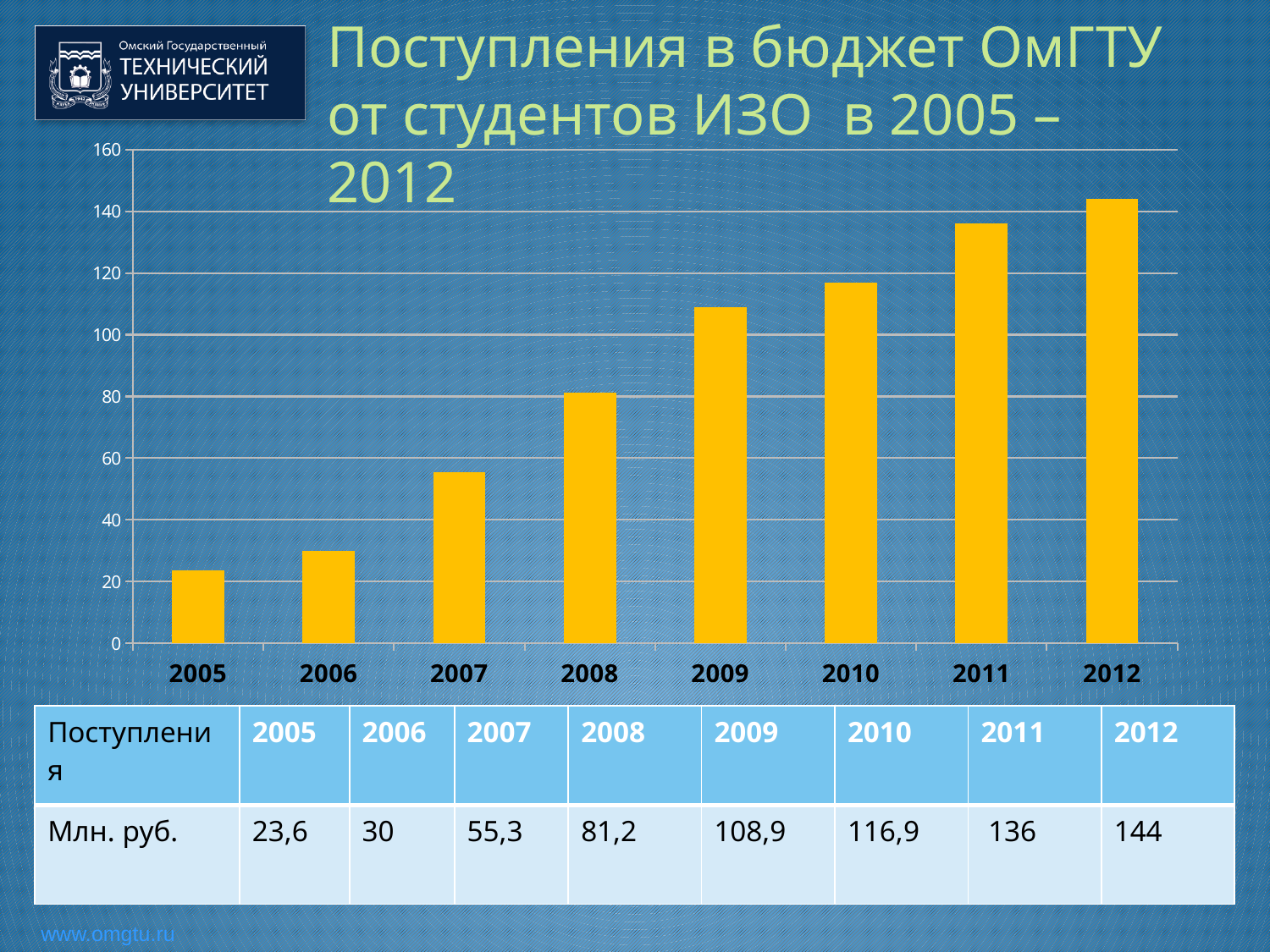
What is the value for 2005 in million rubles? 23,6 What is the difference between the values for 2008 and 2007? 25,9 Which year has the lowest value? 2005 What is the value for 2012 in million rubles? 144 Is the value for 2011 greater or less than 120? greater What type of chart is shown on the slide? bar chart How many years (categories) are plotted on the chart? 8 What is the difference between the values for 2012 and 2011? 8 Do the values rise or fall from 2005 to 2012? rise Which is larger, the value for 2010 or the value for 2008? 2010 Which year has the highest value? 2012 What is the value for 2009 in million rubles? 108,9